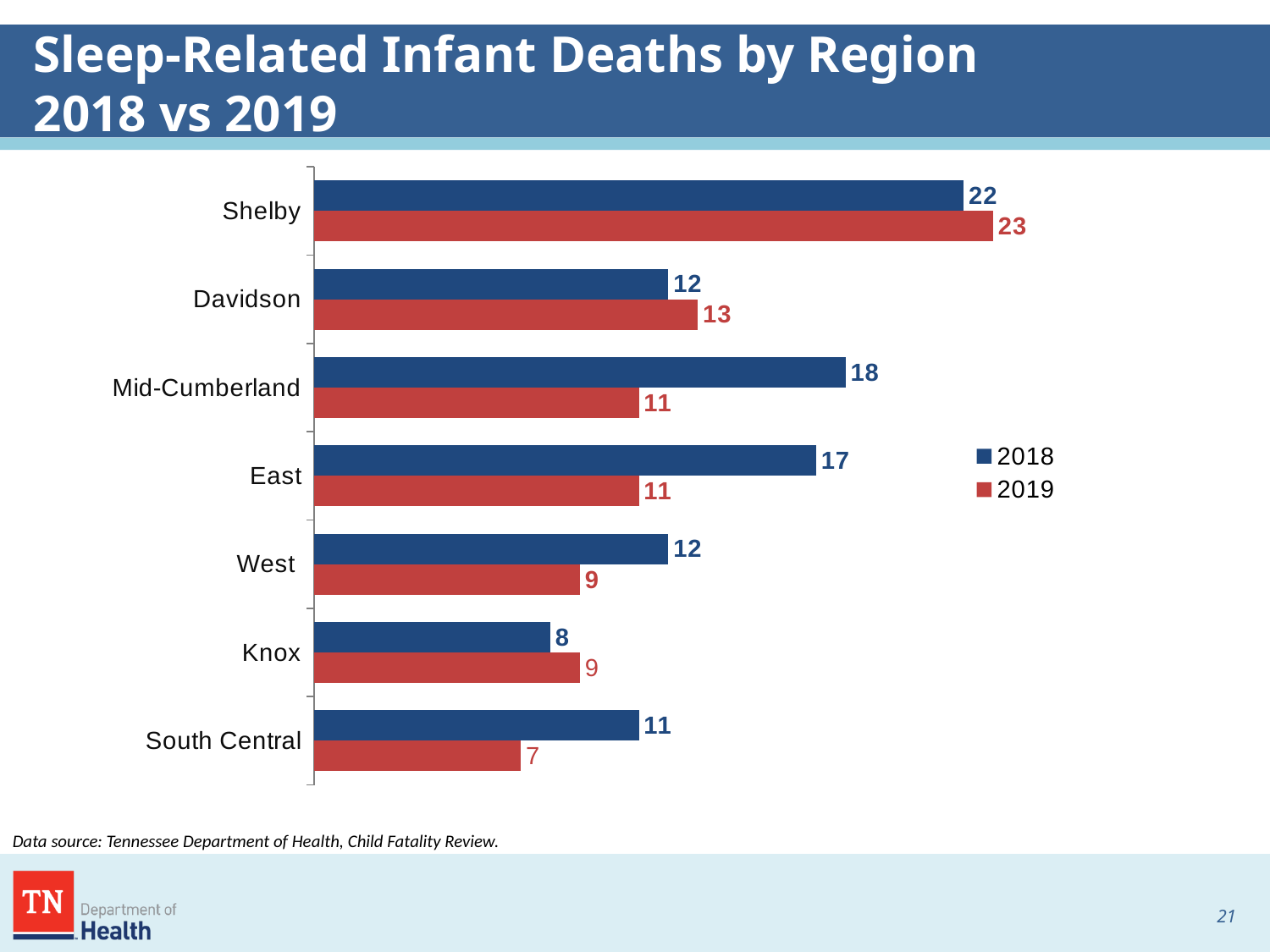
How many regions are shown in the chart? 7 What is the difference between the 2018 and 2019 values for Mid-Cumberland? 7 What kind of chart is shown on the slide? Bar chart Which region had the lowest number of sleep-related infant deaths in 2019? South Central What is the difference between the 2018 and 2019 values for East? 6 How many series does the legend list? 2 What was the number of sleep-related infant deaths in Mid-Cumberland in 2018? 18 Which is larger for Knox: the 2018 value or the 2019 value? 2019 What was the number of sleep-related infant deaths in Shelby in 2019? 23 What was the number of sleep-related infant deaths in South Central in 2019? 7 Which is larger for West: the 2018 value or the 2019 value? 2018 Which region had the highest number of sleep-related infant deaths in 2018? Shelby